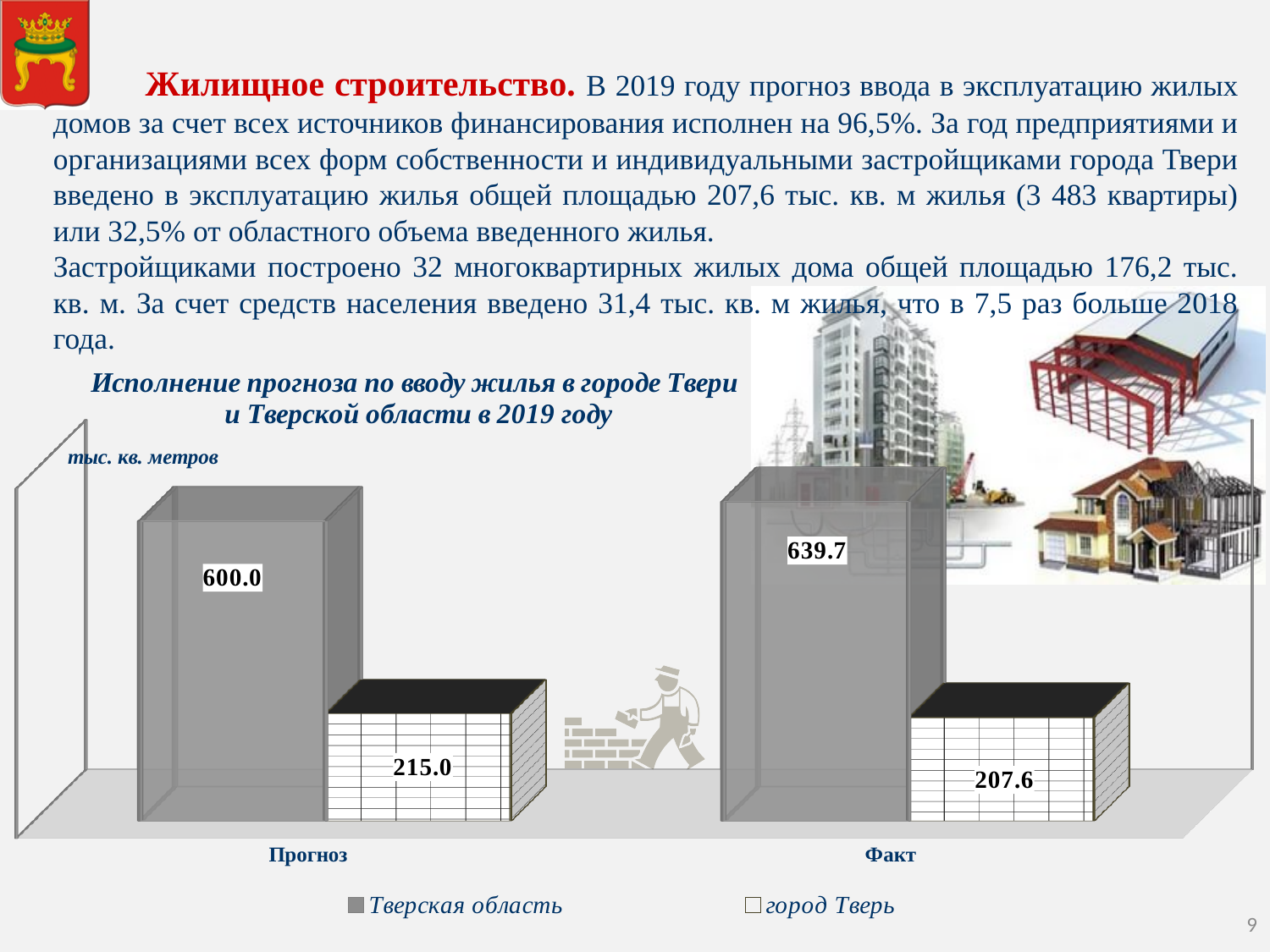
What kind of chart is shown on the slide? Bar chart What is the value for Тверская область in the Факт category? 639.7 How many categories are shown on the x axis? 2 Which category has the lowest value for город Тверь? Факт Which category has the highest value for Тверская область? Факт How many series does the legend list? 2 What is the difference between the Факт and Прогноз values for Тверская область? 39.7 What is the difference between the Прогноз and Факт values for город Тверь? 7.4 What is the value for Тверская область in the Прогноз category? 600.0 Which is larger: the Прогноз value for Тверская область or the Факт value for Тверская область? Факт What is the value for город Тверь in the Факт category? 207.6 What is the value for город Тверь in the Прогноз category? 215.0